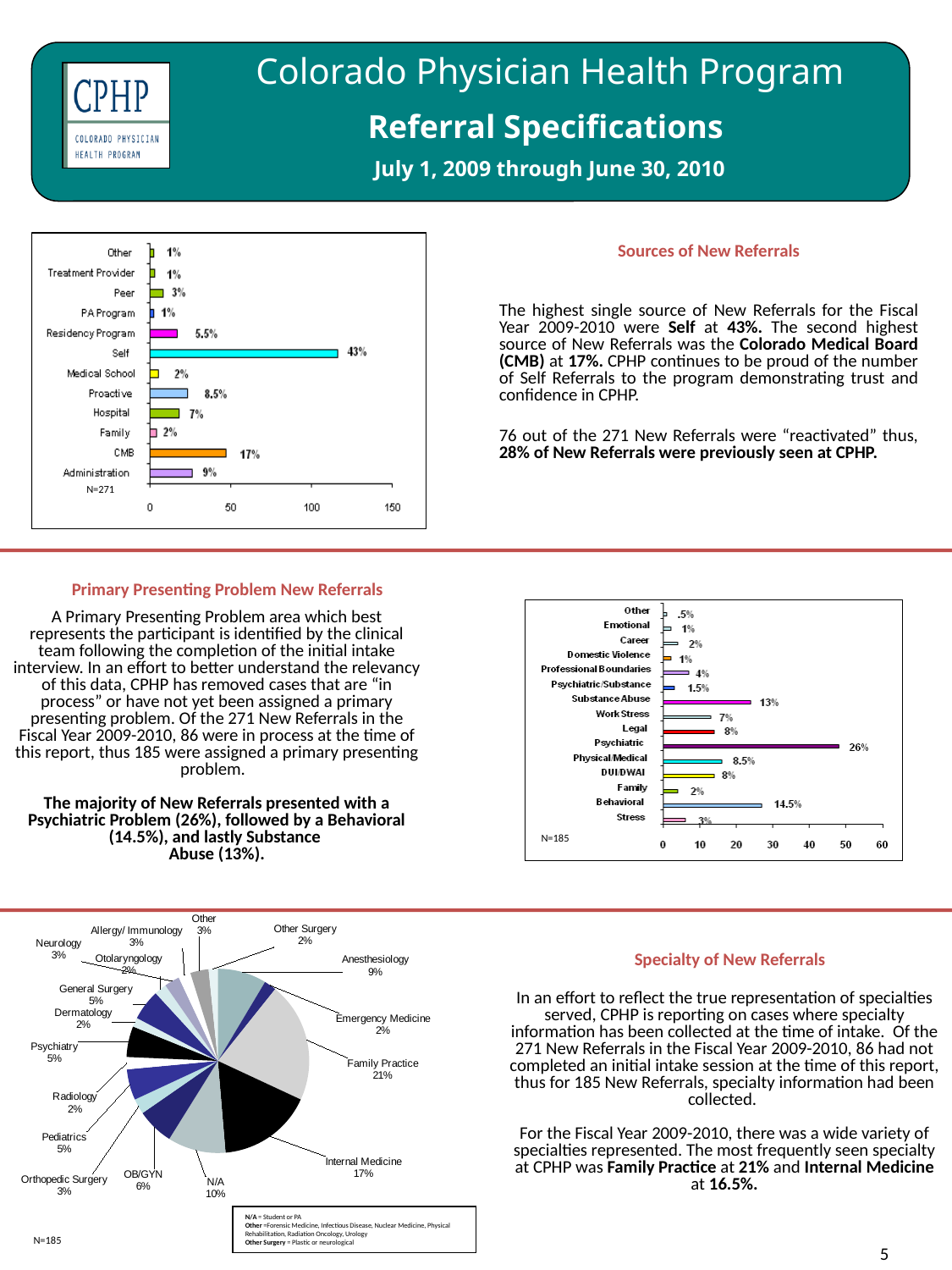
How many categories are shown in the Sources of New Referrals chart? 12 In the Primary Presenting Problem chart, what is the value for Behavioral? 14.5% In the Specialty of New Referrals pie chart, what share does Family Practice have? 21% In the Sources of New Referrals chart, which source has the highest value? Self In the Sources of New Referrals chart, which is larger, Proactive or Hospital? Proactive In the Specialty of New Referrals pie chart, which is larger, Anesthesiology or OB/GYN? Anesthesiology In the Primary Presenting Problem chart, which category has the highest value? Psychiatric In the Sources of New Referrals chart, what is the value for Self? 43% What kind of chart is the Primary Presenting Problem chart? Bar chart In the Sources of New Referrals chart, what is the difference between the values for CMB and Administration? 8% In the Primary Presenting Problem chart, what is the difference between Substance Abuse and Work Stress? 6% In the Primary Presenting Problem chart, which category has the lowest value? Other